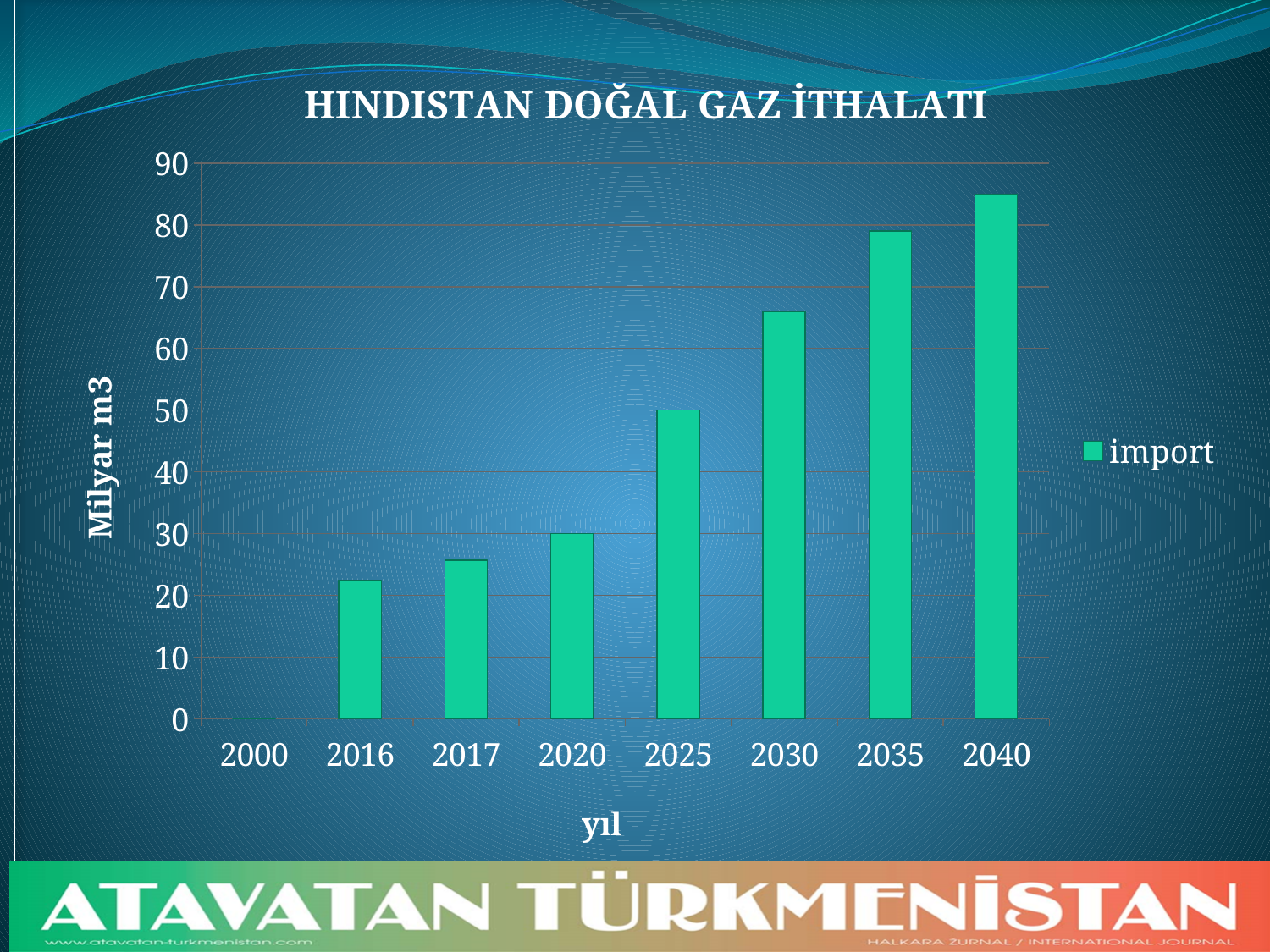
What is the title of the chart? HINDISTAN DOĞAL GAZ İTHALATI Which year has the shortest bar in the chart? 2016 Is the import value for 2040 greater or less than 80? greater Do the import values rise or fall from 2016 to 2040? rise What is the difference between the import values for 2025 and 2020? 20 How many series does the legend list? 1 What type of chart is shown on the slide? bar chart What is the import value for 2020? 30 Which year has the highest import value? 2040 Is the import value for 2016 greater or less than 30? less What is the import value for 2025? 50 Which year has a larger import value, 2030 or 2025? 2030